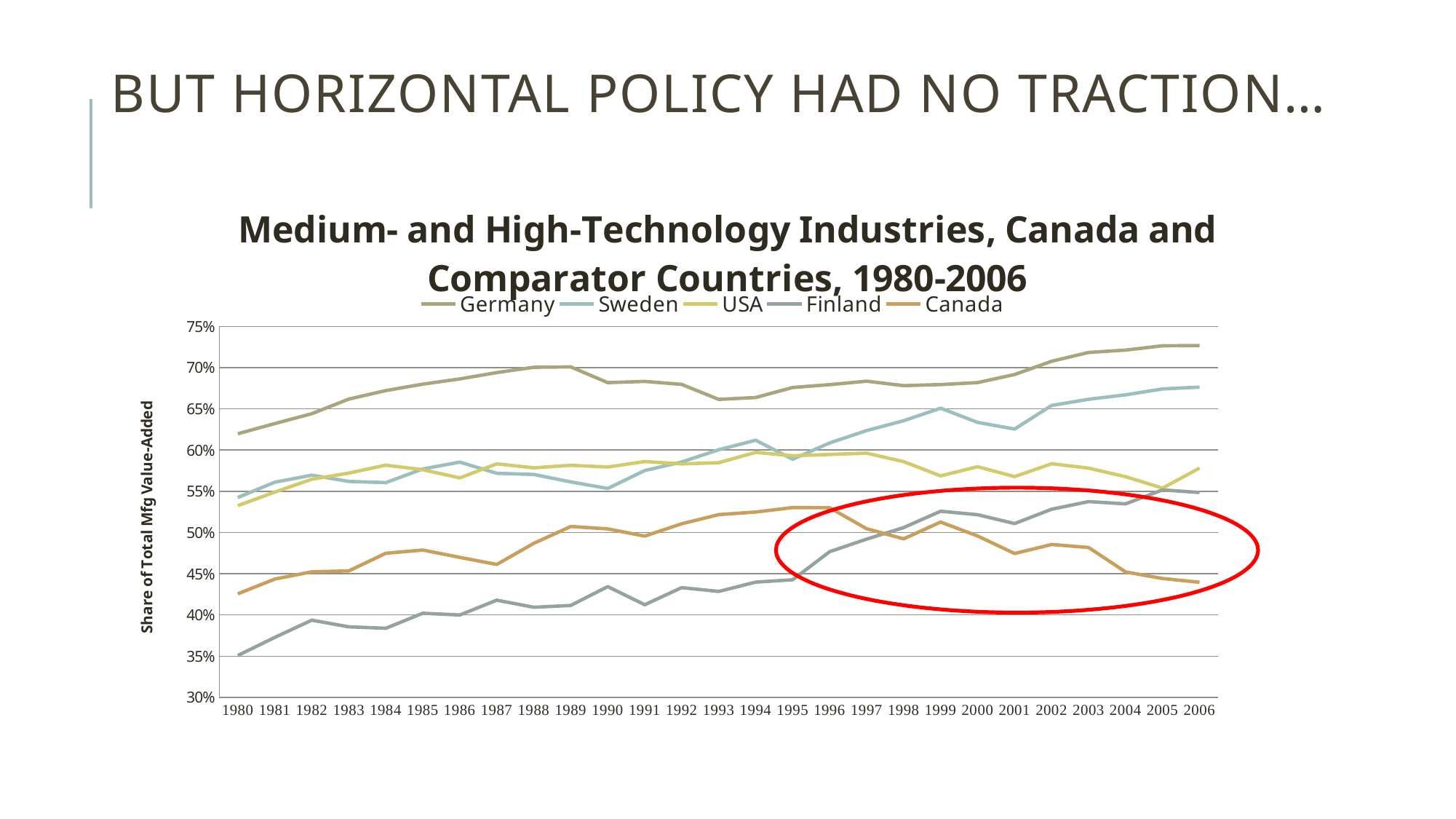
How many years are plotted along the x axis of the chart? 27 Is the value for Finland in 1980 greater or less than 40%? less What kind of chart is shown on the slide? Line chart Is the value for Germany in 2006 greater or less than 70%? greater Does the Finland line rise or fall from 1980 to 2006? Rise Which country has the lowest share in 2006? Canada Which is larger in 2006, the value for Sweden or the value for USA? Sweden How many series does the chart's legend list? 5 Which country has the highest share in 2006? Germany Which country has the lowest share in 1980? Finland What is the label on the chart's vertical axis? Share of Total Mfg Value-Added Is the value for Canada in 2006 greater or less than 50%? less